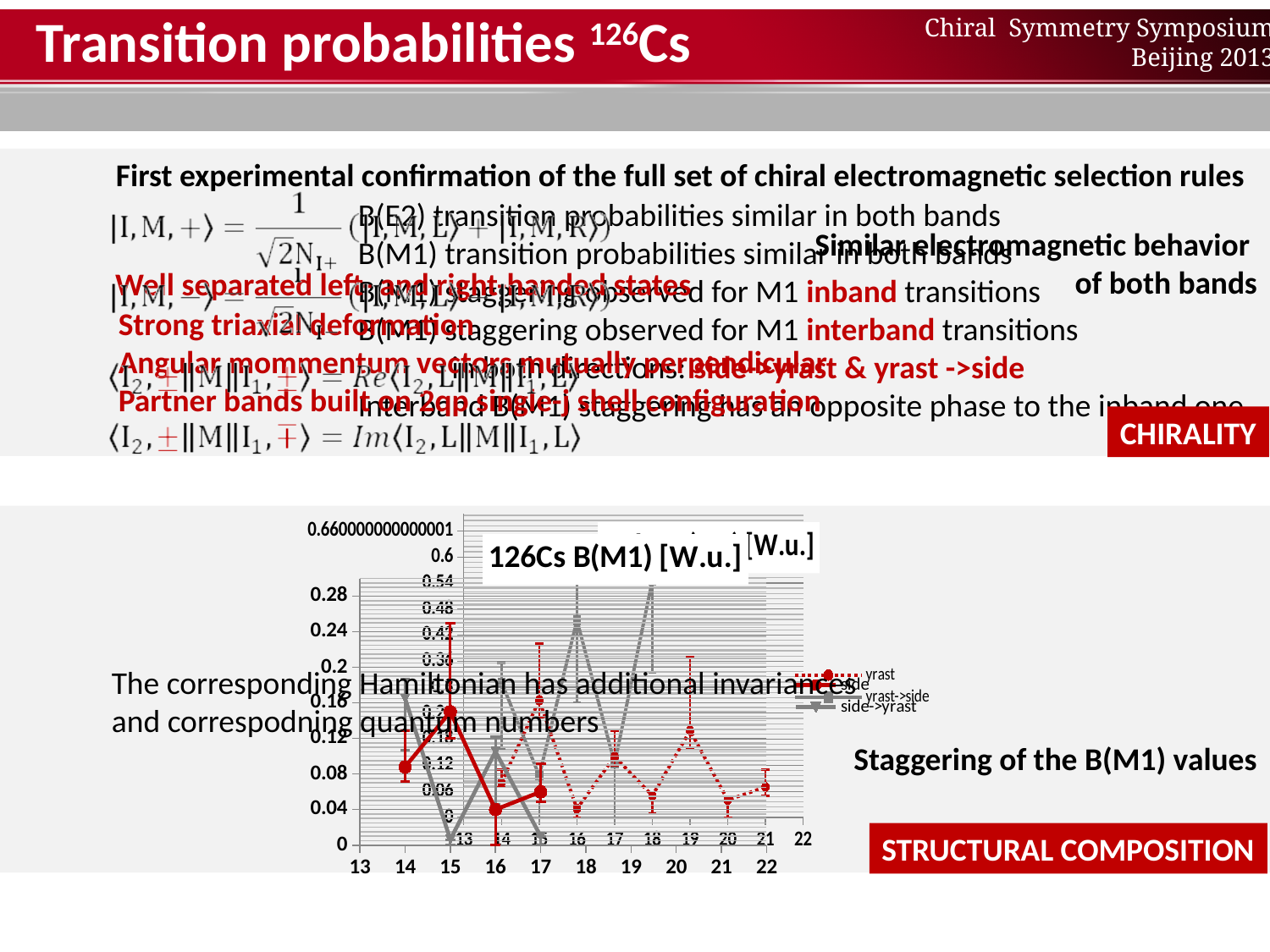
What is the highest value shown on the x axis of the 126Cs B(M1) [W.u.] chart? 22 What is the lowest value shown on the x axis of the 126Cs B(M1) [W.u.] chart? 13 What is the title of the chart on the slide? 126Cs B(M1) [W.u.] What kind of chart is the 126Cs B(M1) [W.u.] chart? line chart How many tick labels are shown along the x axis of the 126Cs B(M1) [W.u.] chart (from 13 to 22)? 10 What unit is given in the title of the 126Cs B(M1) chart? W.u.